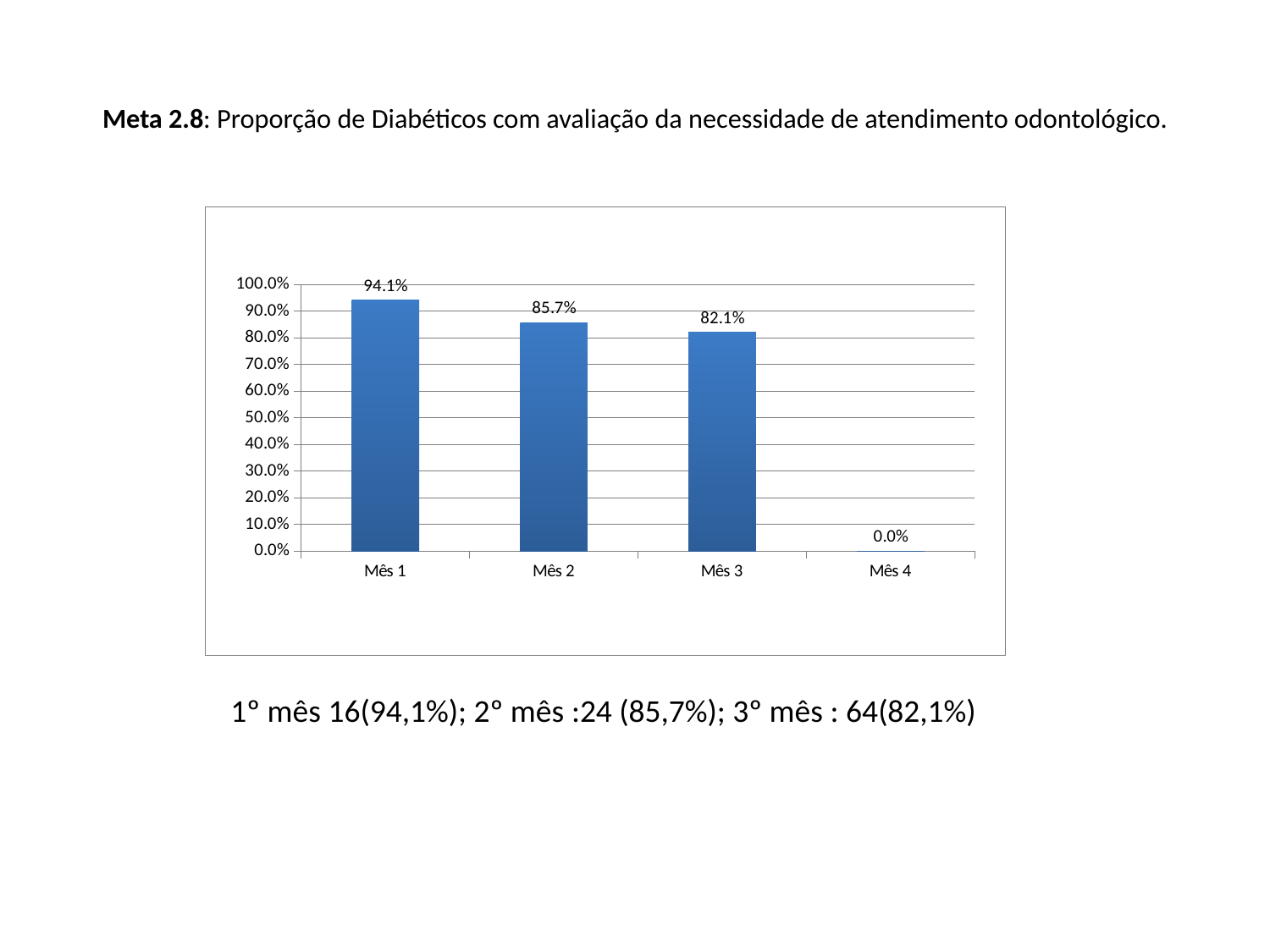
Which month has the lowest value? Mês 4 How many months are shown on the x axis? 4 Do the values rise or fall from Mês 1 to Mês 3? Fall What kind of chart is shown on the slide? Bar chart Which is larger, the value for Mês 2 or the value for Mês 3? Mês 2 Which month has the highest value? Mês 1 What is the value for Mês 1? 94.1% What is the value for Mês 4? 0.0% What is the value for Mês 3? 82.1% What is the value for Mês 2? 85.7% What is the difference between the values for Mês 2 and Mês 3? 3.6% What is the difference between the values for Mês 1 and Mês 2? 8.4%